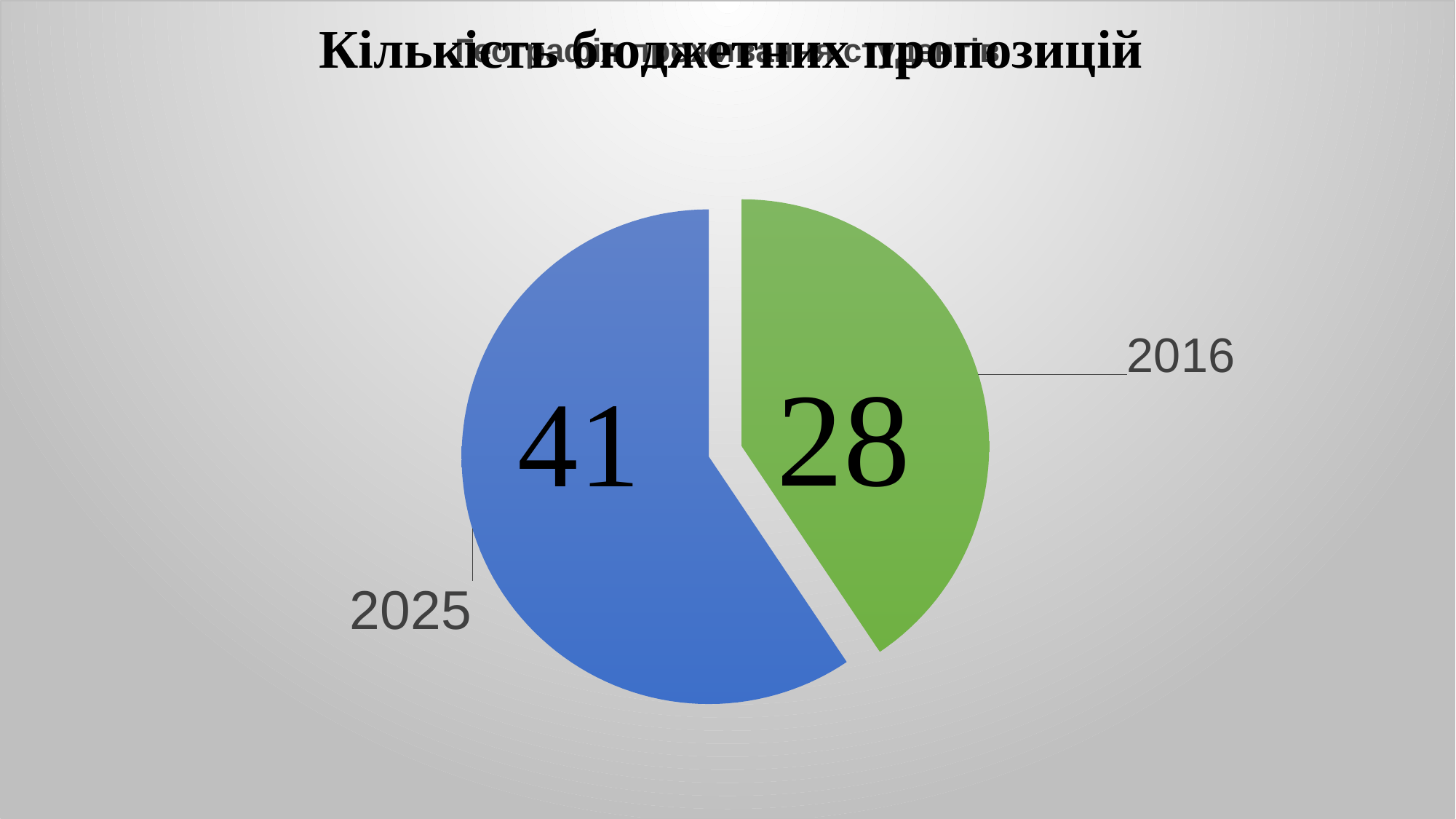
What is the value for 2016? 28 Which is larger, the value for 2025 or the value for 2016? 2025 Which category has the largest slice? 2025 What is the difference between the values for 2025 and 2016? 13 What share of the pie does the 2025 slice represent, to the nearest whole percent? 59% What colour is the slice for 2016? green What type of chart is shown on the slide? pie chart How many slices does the pie chart have? 2 What is the title of the chart? Кількість бюджетних пропозицій What is the total of all slices in the pie chart? 69 What is the value for 2025? 41 Which category has the smallest slice? 2016